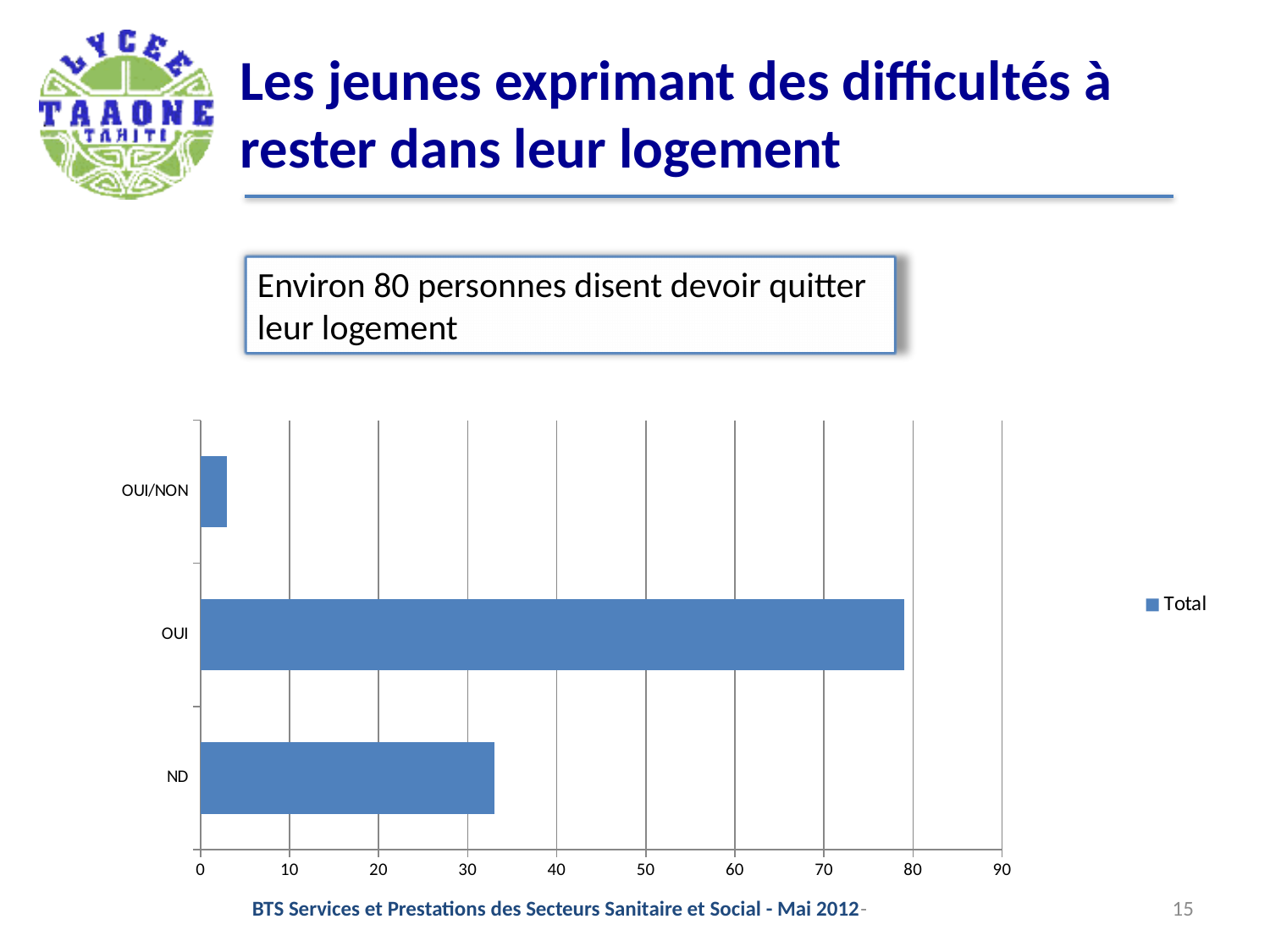
Which is larger, the value for ND or the value for OUI/NON? ND What kind of chart is shown on the slide? bar chart How many categories are shown on the chart? 3 Is the value for ND greater or less than 40? less Which category has the lowest value? OUI/NON What series name is shown in the chart legend? Total Which category has the highest value? OUI Is the value for OUI greater or less than 70? greater Is the value for OUI/NON greater or less than 10? less Which is larger, the value for OUI or the value for ND? OUI How many series does the chart legend list? 1